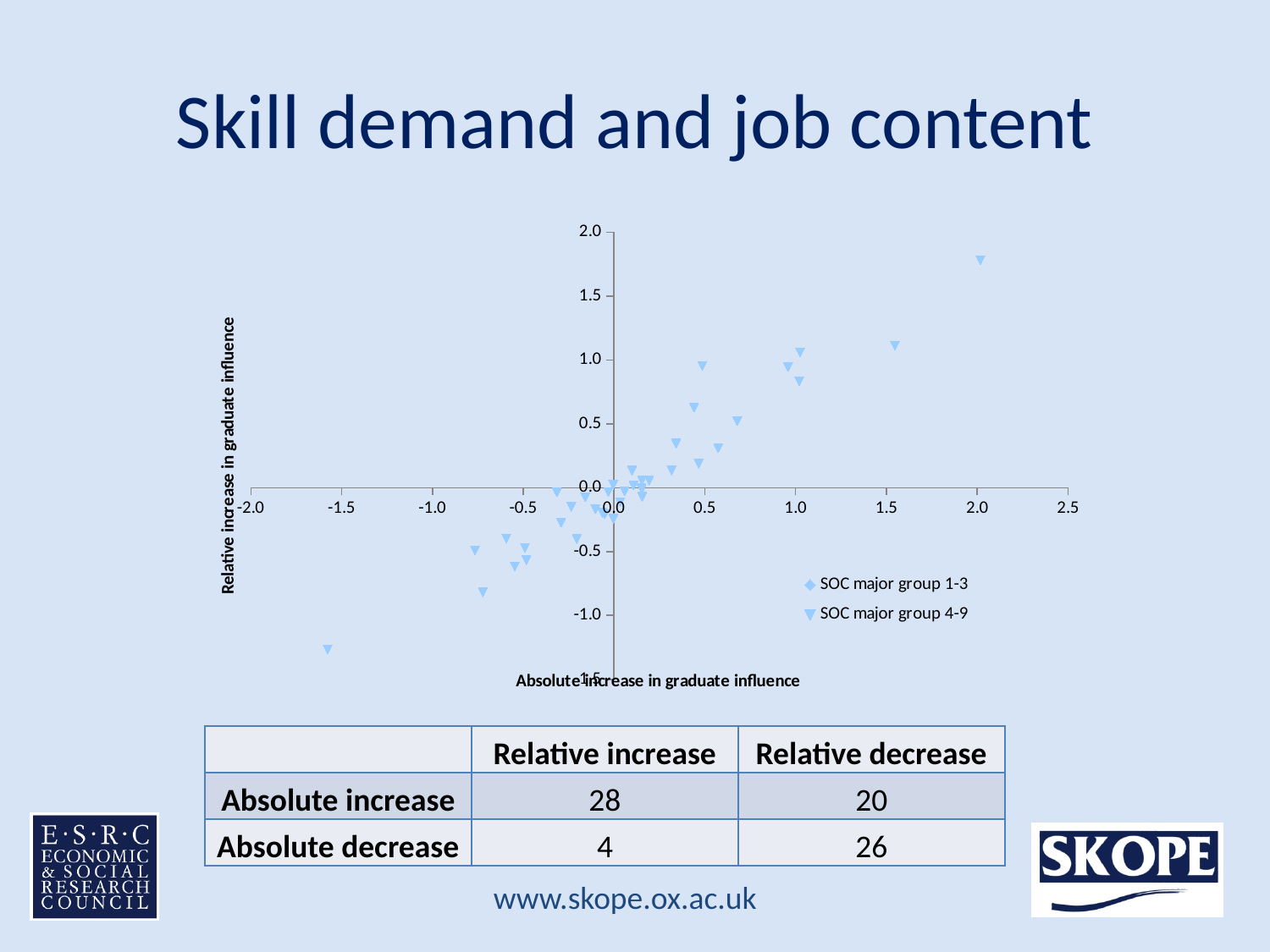
What are the two series named in the chart's legend? SOC major group 1-3 and SOC major group 4-9 How many series does the chart's legend list? 2 Is the absolute increase value of the leftmost plotted point greater or less than -1.5? less Is the relative increase value of the highest plotted point greater or less than 1.5? greater What is the title of the chart's vertical axis? Relative increase in graduate influence Is the relative increase value of the lowest plotted point greater or less than -1.0? less As the absolute increase in graduate influence rises along the x axis, do the plotted points generally rise or fall? Rise What kind of chart is shown on the slide? Scatter chart